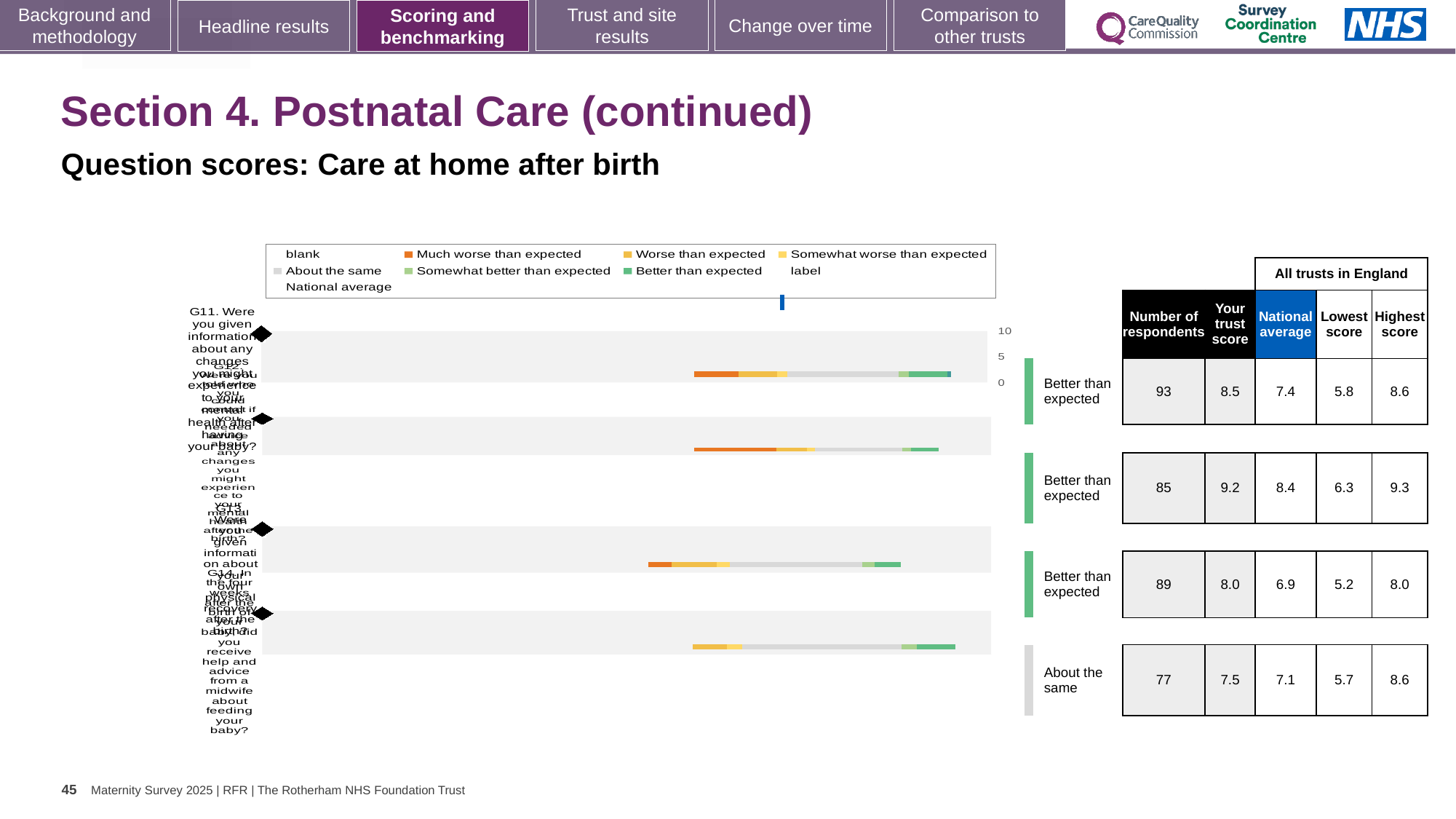
How many question rows are plotted in the chart? 4 What is the National average for the second row? 8.4 What is the 'Your trust score' for the first (top) row? 8.5 For the third row, which is larger: 'Your trust score' or the National average? Your trust score What is the Highest score for the third row? 8.0 Which row has the lowest 'Your trust score'? the fourth row (7.5) What kind of chart is shown on the slide? bar chart Which row has the highest 'Your trust score'? the second row (9.2) For the first (top) row, what is the difference between 'Your trust score' and the National average? 1.1 What benchmark label is given for the fourth (bottom) row? About the same What is the Number of respondents for the fourth (bottom) row? 77 What colour represents 'Better than expected' in the legend? green